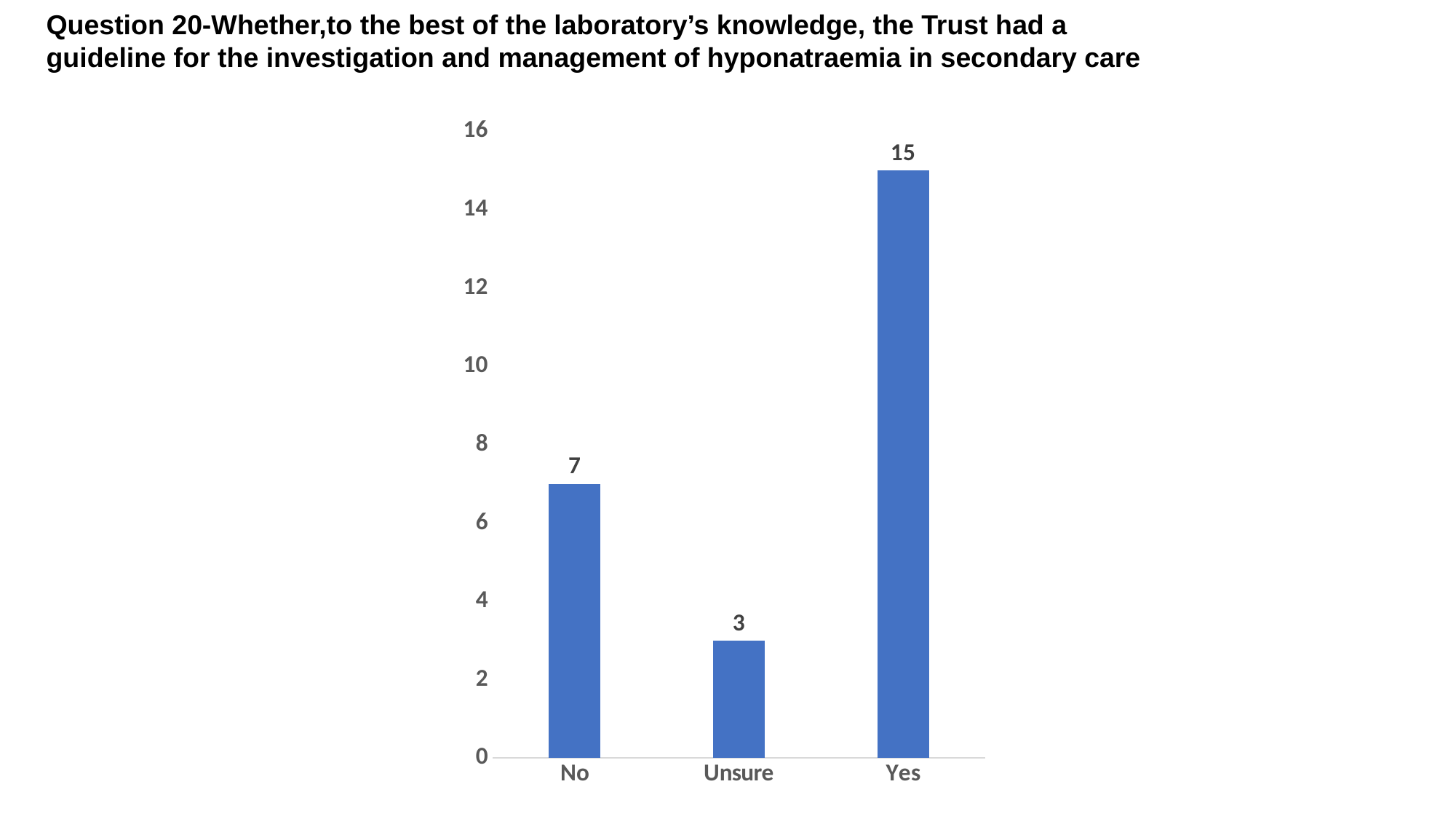
What is the value for the "Yes" category? 15 What is the total of the three values shown in the chart? 25 Which is larger, the value for "No" or the value for "Unsure"? No What is the value for the "Unsure" category? 3 What kind of chart is shown on the slide? Bar chart Is the value for "Yes" greater or less than 10? greater Which category has the highest value? Yes What is the difference between the values for "Yes" and "No"? 8 What is the value for the "No" category? 7 How many categories are shown on the x axis? 3 Which category has the lowest value? Unsure What is the difference between the values for "No" and "Unsure"? 4